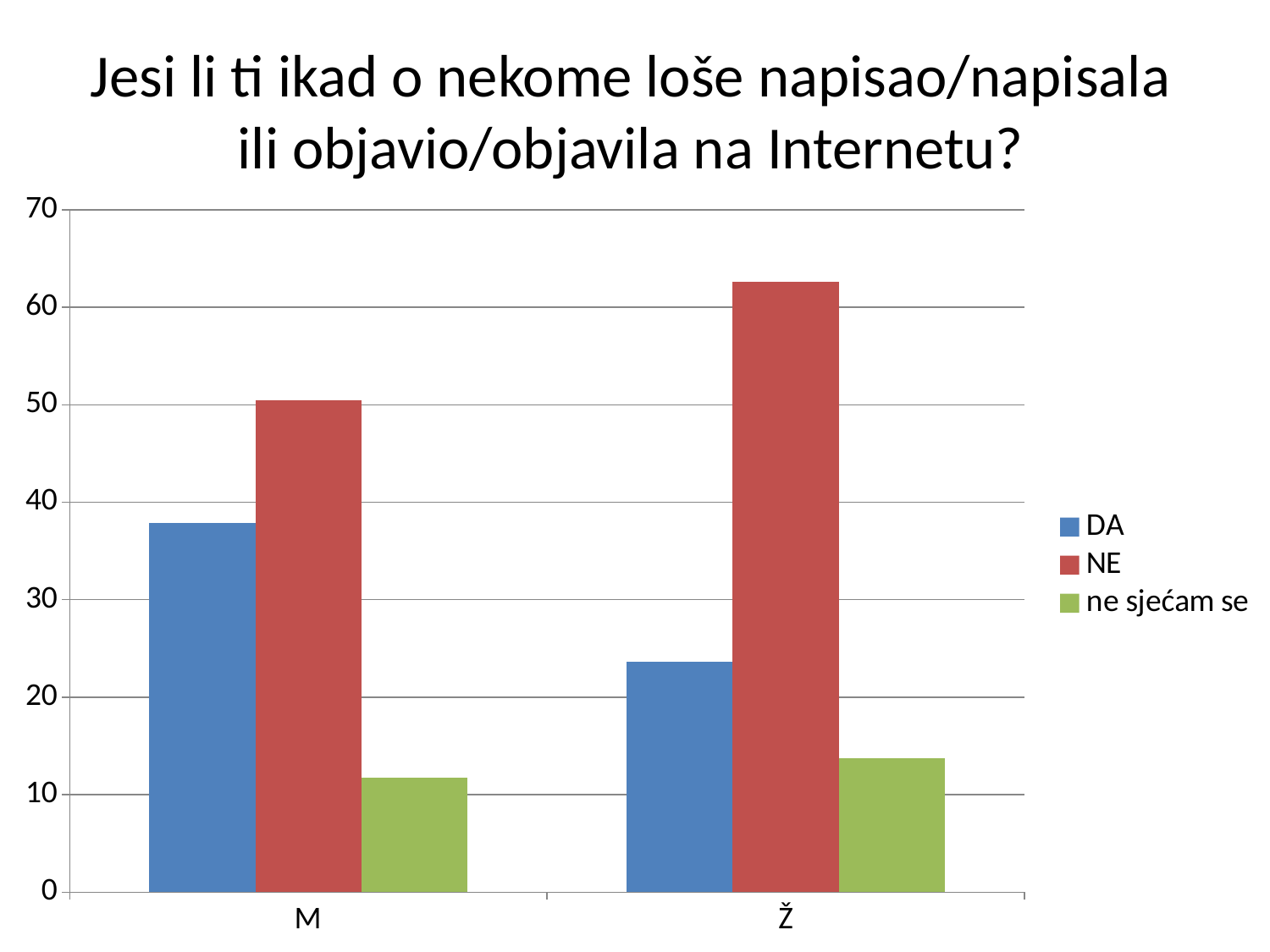
How many categories are shown on the x axis? 2 Which is larger: the DA value for M or the DA value for Ž? M Which series has the lowest value for category M? ne sjećam se Is the value for ne sjećam se in category Ž greater or less than 10? greater Which is larger: the NE value for M or the NE value for Ž? Ž Which series has the highest value for category Ž? NE Is the value for DA in category Ž greater or less than 30? less What colour are the bars for the NE series? red Is the value for DA in category M greater or less than 40? less What kind of chart is shown on the slide? bar chart How many series does the legend list? 3